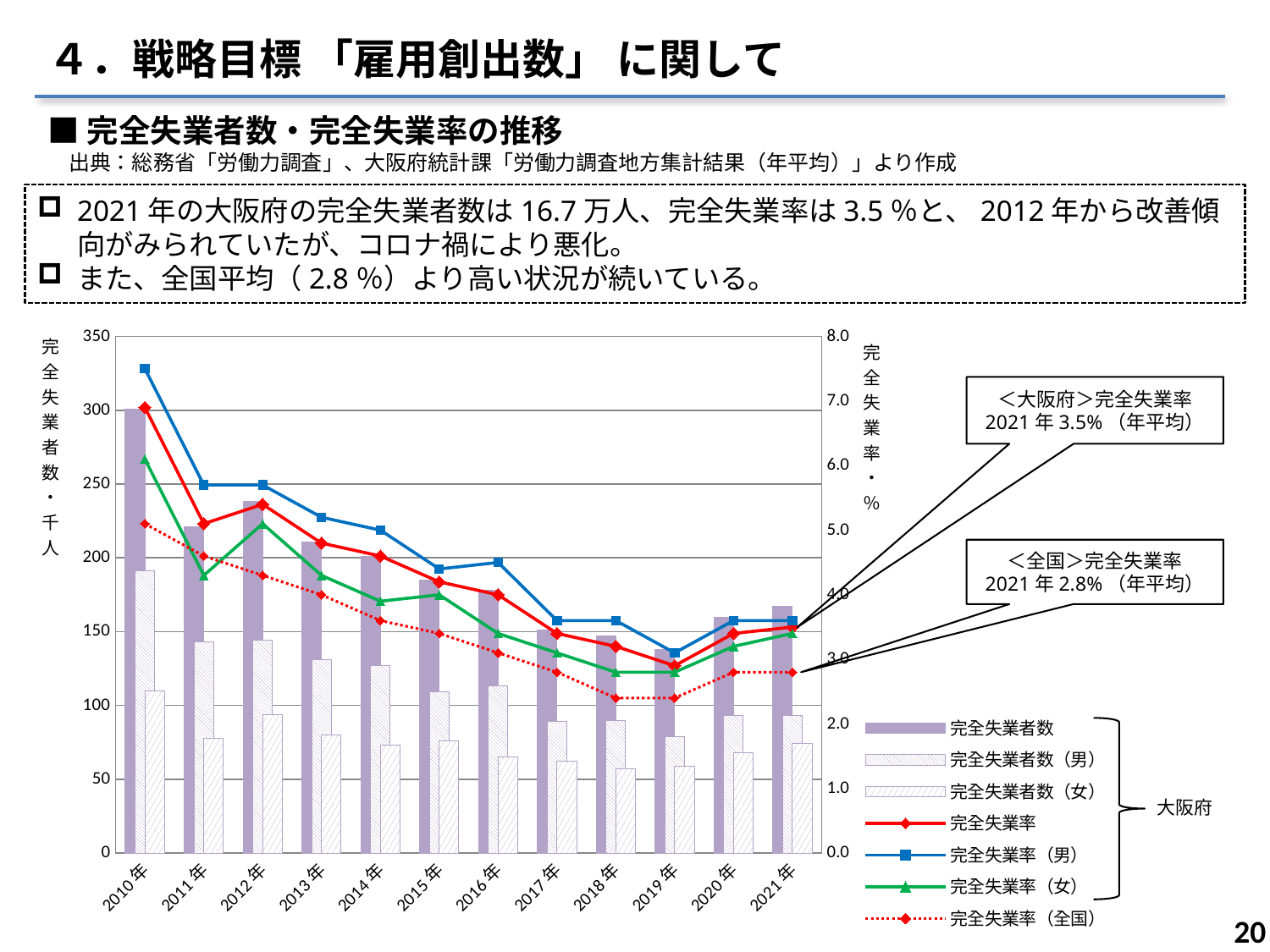
How many years are shown along the x axis of the chart? 12 In which year is the total number of unemployed persons (完全失業者数) bar the lowest? 2019年 In which year is the total number of unemployed persons (完全失業者数) bar the highest? 2010年 Is the national unemployment rate (完全失業率（全国）) in 2018 greater or less than 3.0? less What kind of chart is shown on the slide? A combined bar and line chart Is the total number of unemployed persons (完全失業者数) in 2019 greater or less than 150 thousand? less How many series does the chart legend list? 7 According to the callout, what was the national (全国) unemployment rate in 2021? 2.8% Is the male unemployment rate (完全失業率（男）) in 2010 greater or less than 7.0? greater According to the callout, what was the Osaka Prefecture unemployment rate (完全失業率) in 2021? 3.5% Does the Osaka Prefecture unemployment rate (完全失業率) generally rise or fall from 2010 to 2019? fall In 2021, which is higher: the Osaka Prefecture unemployment rate or the national unemployment rate? Osaka Prefecture